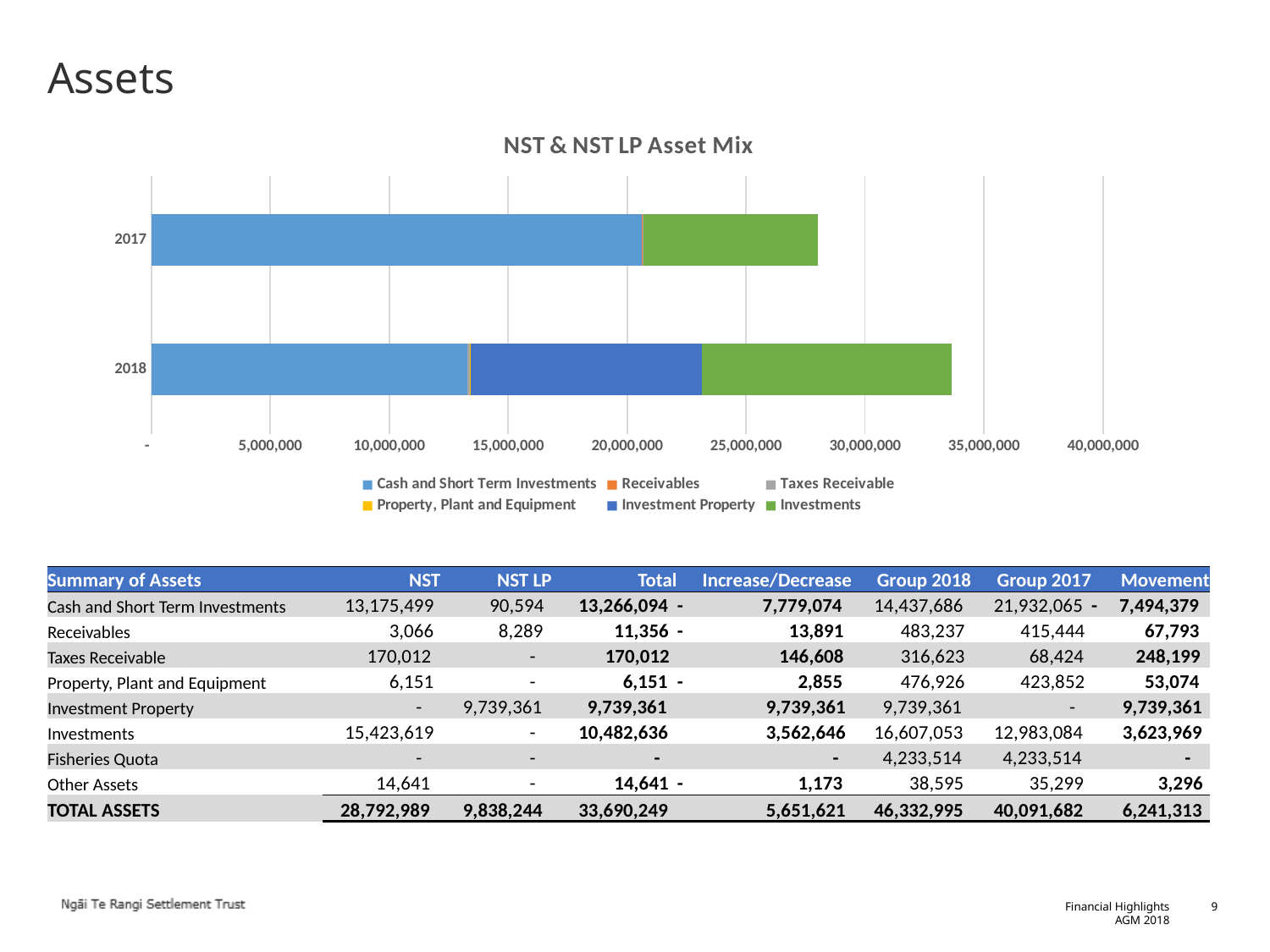
Does the total asset bar rise or fall from 2017 to 2018 in the NST & NST LP Asset Mix chart? Rise Is the total length of the 2017 bar in the NST & NST LP Asset Mix chart greater or less than 30,000,000? less What colour represents Investments in the NST & NST LP Asset Mix chart? Green Which year shows an Investment Property segment in the NST & NST LP Asset Mix chart? 2018 Which year has the larger Cash and Short Term Investments segment in the NST & NST LP Asset Mix chart, 2017 or 2018? 2017 What type of chart is shown under the title 'NST & NST LP Asset Mix'? Stacked bar chart Is the Cash and Short Term Investments segment for 2018 in the NST & NST LP Asset Mix chart greater or less than 10,000,000? greater Which year has the longer total bar in the NST & NST LP Asset Mix chart, 2017 or 2018? 2018 How many years (categories) are plotted in the NST & NST LP Asset Mix chart? 2 Is the Cash and Short Term Investments segment for 2018 in the NST & NST LP Asset Mix chart greater or less than 15,000,000? less How many series does the legend of the NST & NST LP Asset Mix chart list? 6